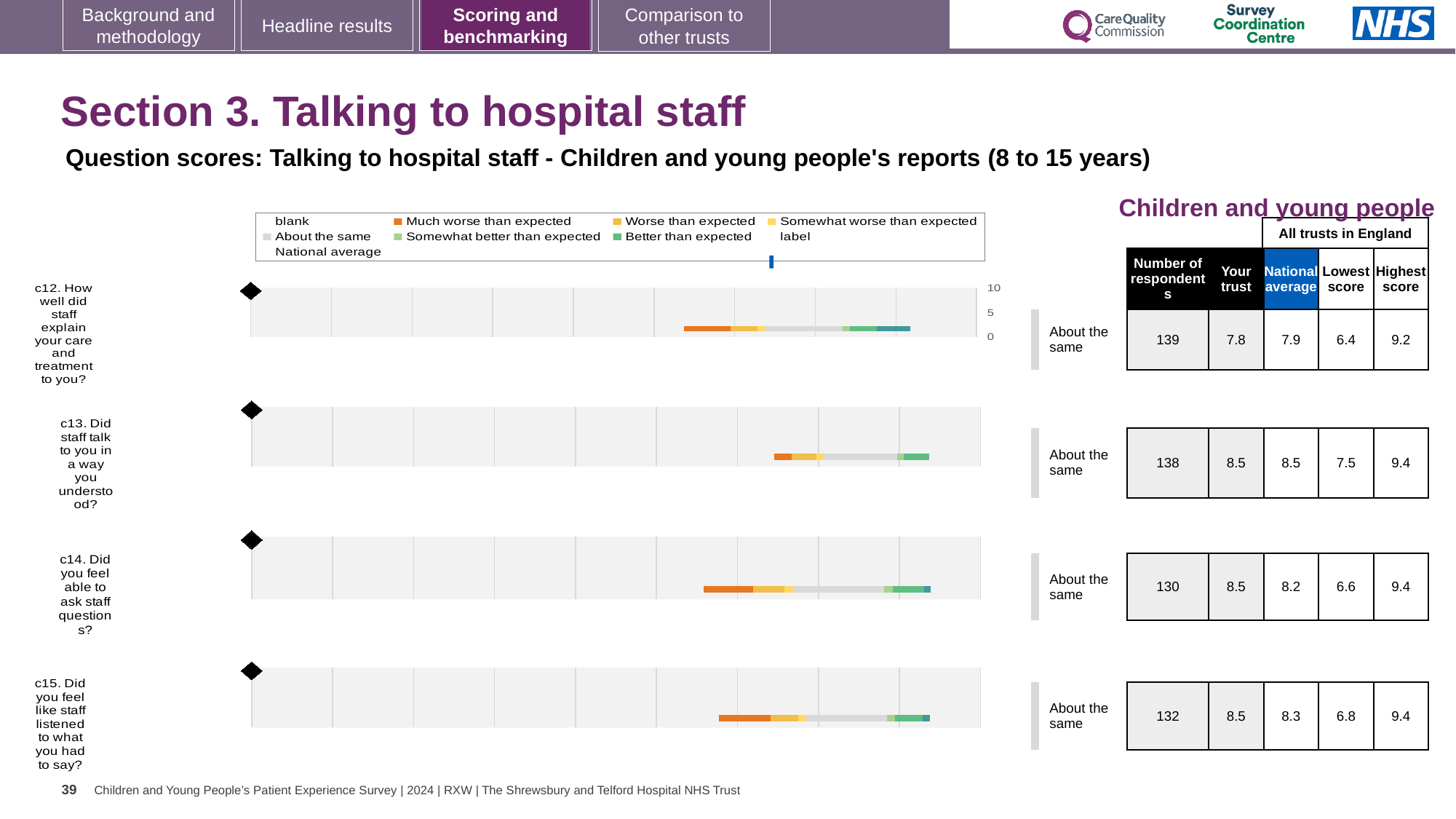
What benchmark category is shown next to the c13 chart? About the same In the chart legend, which category is shown in orange? Much worse than expected For the c13 chart (Did staff talk to you in a way you understood?), what is the highest score across all trusts in England? 9.4 For the c12 chart, which is larger: the 'Your trust' score or the national average? National average How many questions (c12 to c15) are plotted as separate bar charts on the slide? 4 For the c14 chart (Did you feel able to ask staff questions?), what is the national average score? 8.2 Which question has the highest number of respondents? c12 Which question has the lowest 'Lowest score' across all trusts in England? c12 For the c12 chart (How well did staff explain your care and treatment to you?), what is the 'Your trust' score? 7.8 For the c14 chart, what is the difference between the 'Your trust' score and the national average? 0.3 For the c12 chart, is the 'Your trust' score greater or less than 5? greater What kind of chart is used to show the question scores for c12 to c15? bar chart